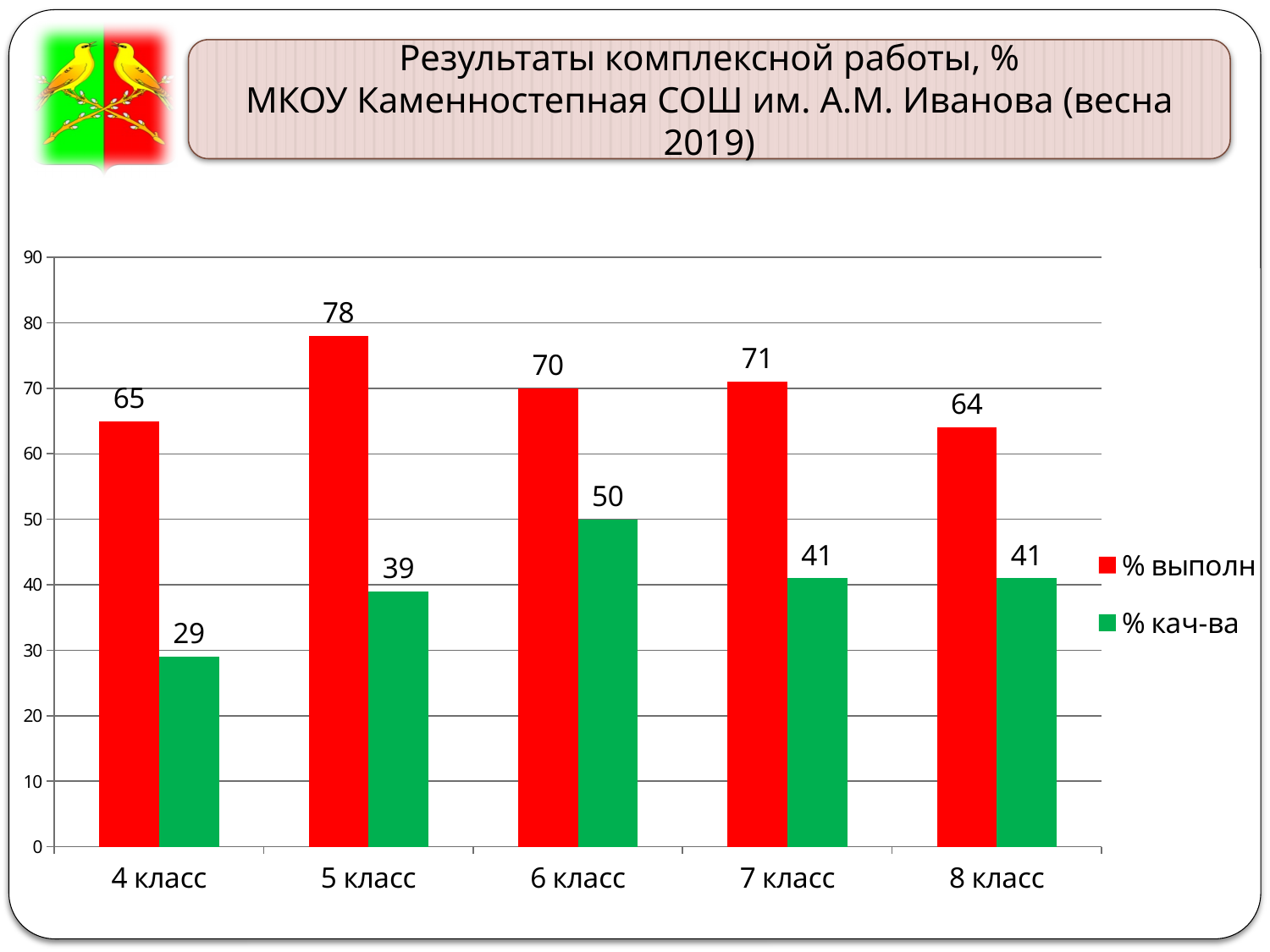
How many series does the legend list? 2 Is the % выполн value for 8 класс greater or less than 60? greater What is the % выполн value for 5 класс? 78 What is the % кач-ва value for 4 класс? 29 Which class has the highest % выполн value? 5 класс How many classes are shown on the x axis? 5 Which colour represents the % кач-ва series? green Which class has the lowest % кач-ва value? 4 класс What is the difference in % выполн between 5 класс and 8 класс? 14 What is the difference between % выполн and % кач-ва for 6 класс? 20 Which is larger: the % кач-ва value for 5 класс or for 6 класс? 6 класс What kind of chart is shown on the slide? bar chart